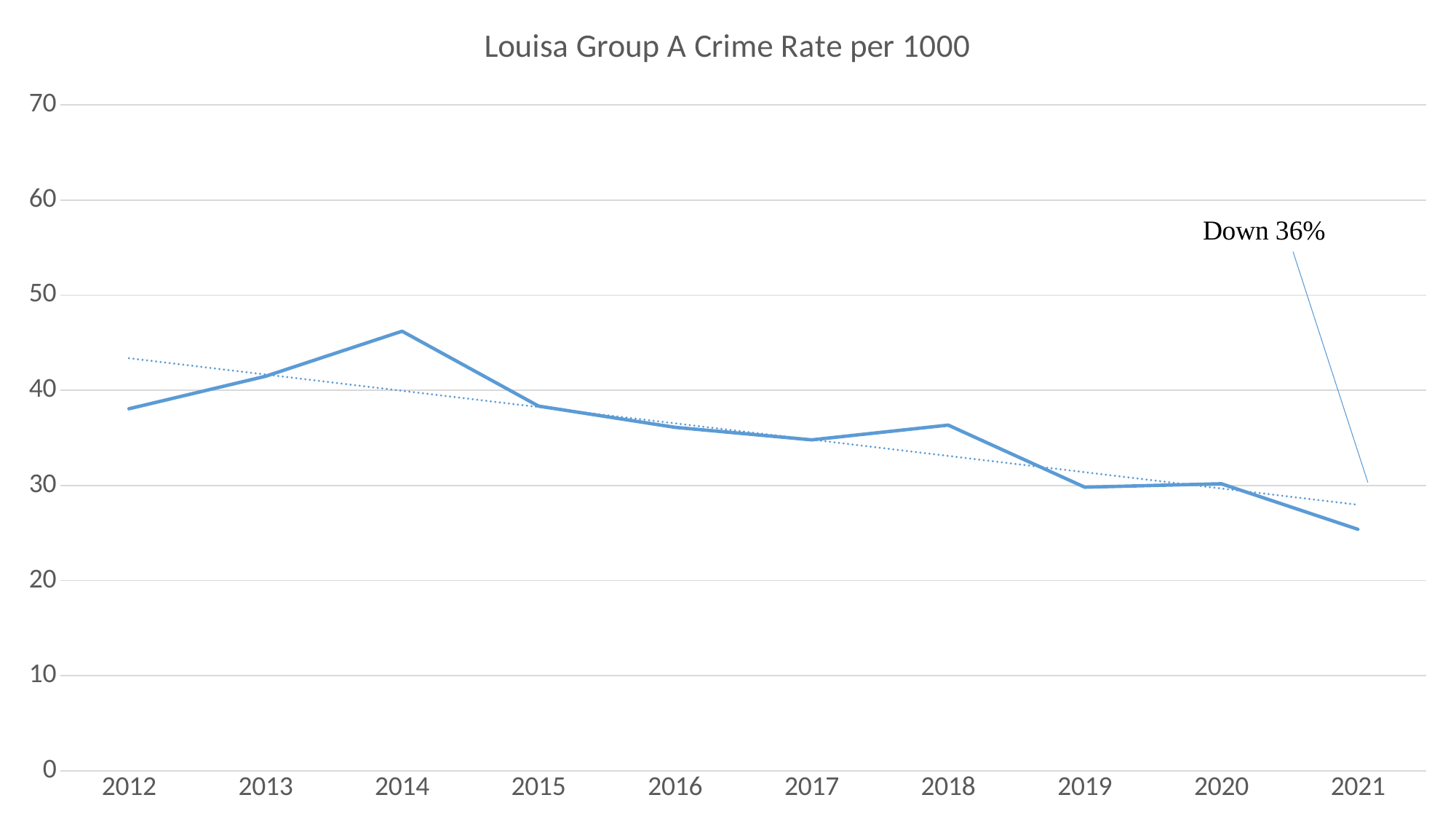
Which year has the highest crime rate? 2014 Is the value for 2012 greater or less than 40? less Overall, does the crime rate rise or fall from 2012 to 2021? fall Is the value for 2014 greater or less than 40? greater How many years are plotted along the x axis? 10 Which year has the lowest crime rate? 2021 Is the value for 2017 greater or less than 30? greater What does the annotation near the 2021 end of the line say? Down 36% Which year has the larger crime rate, 2014 or 2019? 2014 What kind of chart is shown on the slide? line chart What is the title of the chart? Louisa Group A Crime Rate per 1000